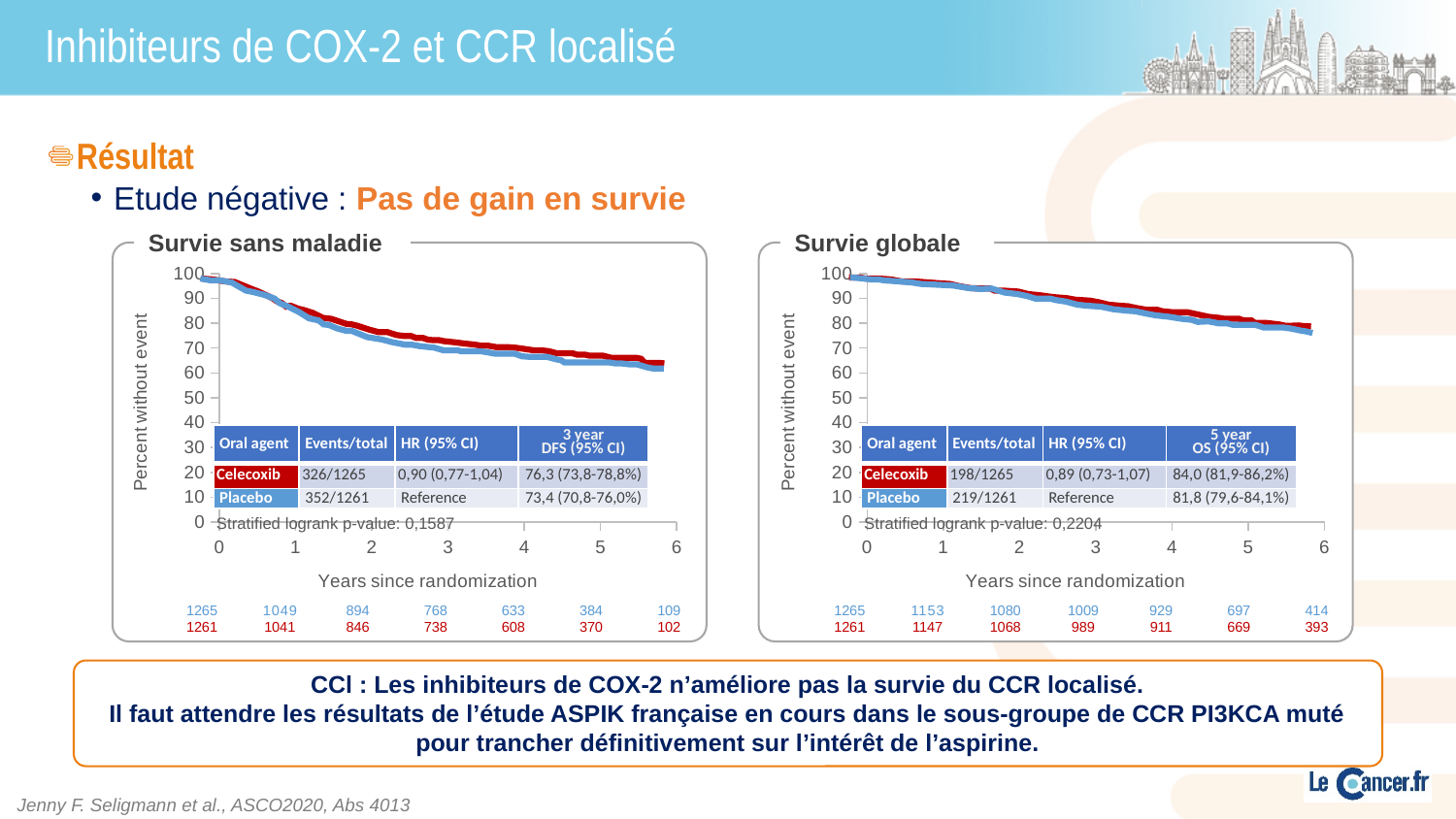
How many treatment groups (series) are plotted in the 'Survie globale' chart? 2 In the 'Survie globale' chart, do the survival curves rise or fall as years since randomization increase? fall In the 'Survie sans maladie' chart, what is the stratified logrank p-value? 0,1587 In the 'Survie globale' chart, how many more events did Placebo have than Celecoxib? 21 In the 'Survie globale' chart, what is the 5 year OS (95% CI) for Celecoxib? 84,0 (81,9-86,2%) In the 'Survie sans maladie' chart, at year 3 are the curves greater or less than 80 percent without event? less In the 'Survie sans maladie' chart, what is the HR (95% CI) for Celecoxib? 0,90 (0,77-1,04) In the 'Survie sans maladie' chart, which oral agent has more events, Celecoxib or Placebo? Placebo What kind of chart is the 'Survie sans maladie' chart? line chart In the 'Survie globale' chart, at year 6 are the curves greater or less than 70 percent without event? greater In the 'Survie globale' chart, what is the Events/total for Celecoxib? 198/1265 In the 'Survie sans maladie' chart, what is the 3 year DFS (95% CI) for Placebo? 73,4 (70,8-76,0%)